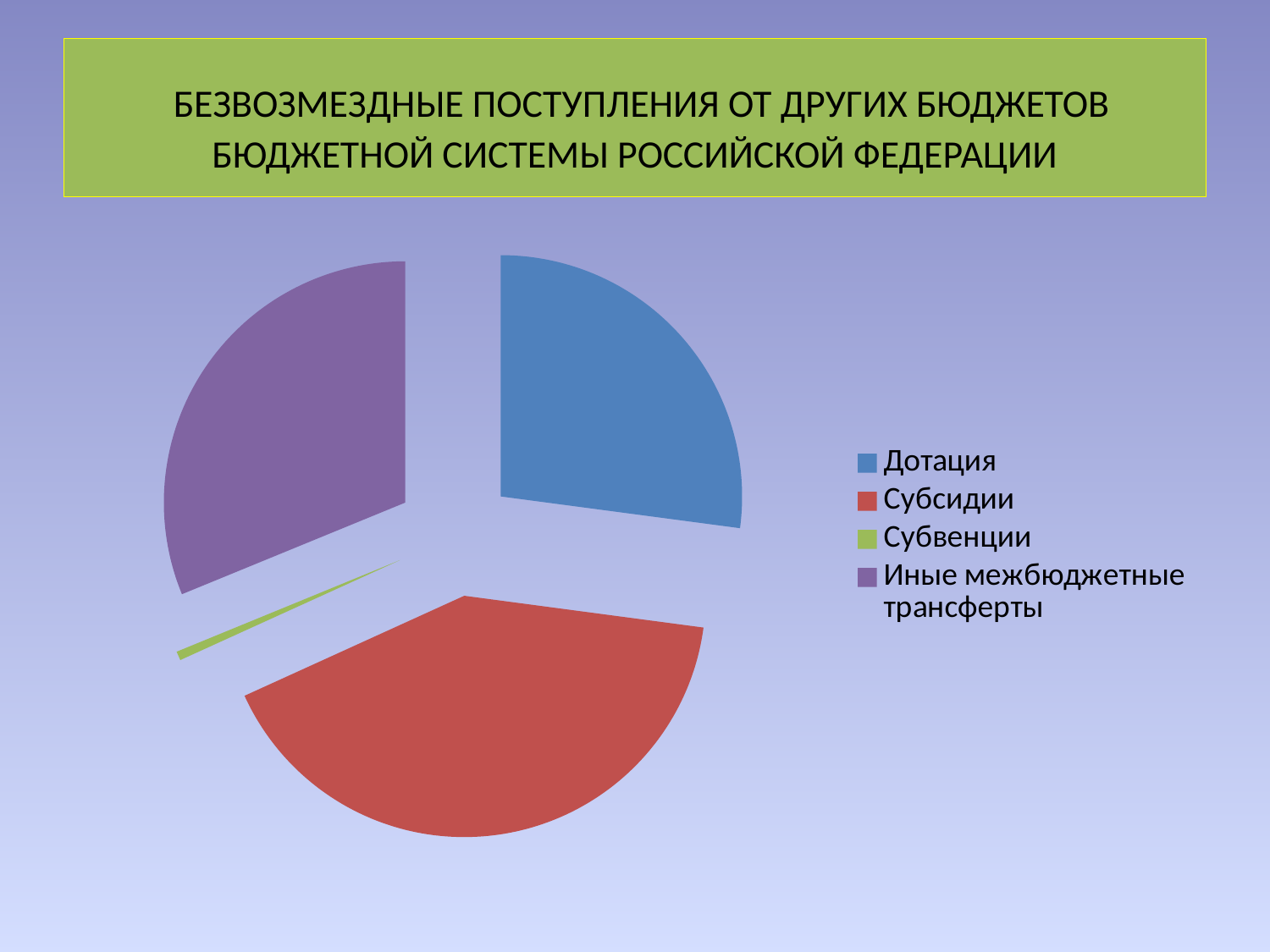
Which slice is larger, Иные межбюджетные трансферты or Субвенции? Иные межбюджетные трансферты How many slices does the pie chart have? 4 Which slice is larger, Дотация or Субвенции? Дотация What kind of chart is shown on the slide? pie chart Which category is shown in purple in the pie chart? Иные межбюджетные трансферты Which category has the smallest slice of the pie? Субвенции What is the title of the slide? БЕЗВОЗМЕЗДНЫЕ ПОСТУПЛЕНИЯ ОТ ДРУГИХ БЮДЖЕТОВ БЮДЖЕТНОЙ СИСТЕМЫ РОССИЙСКОЙ ФЕДЕРАЦИИ Which category has the largest slice of the pie? Субсидии Which slice is larger, Субсидии or Дотация? Субсидии